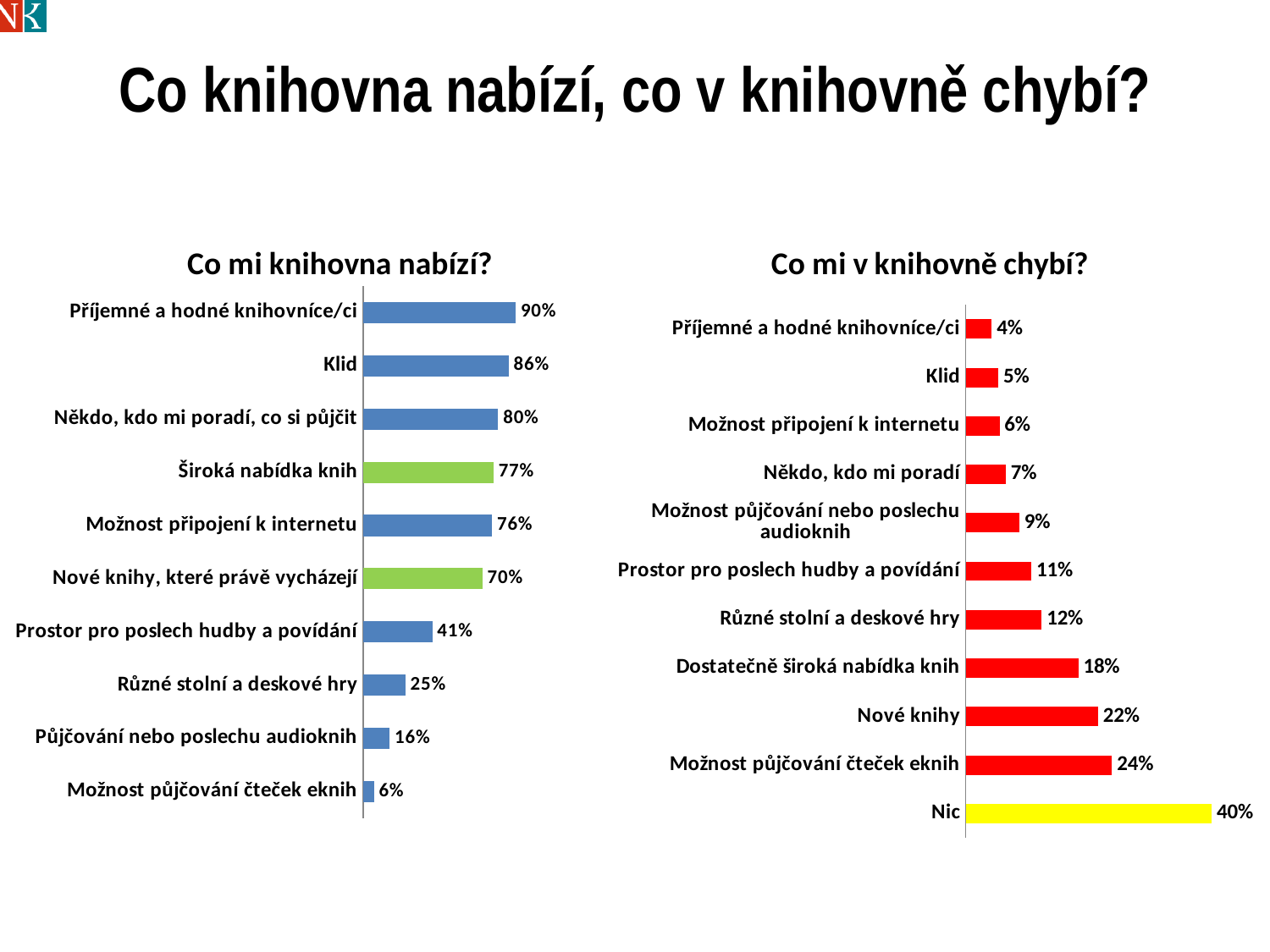
In the chart "Co mi v knihovně chybí?", what is the difference between "Možnost půjčování čteček eknih" and "Nic"? 16% How many categories are shown in the chart "Co mi v knihovně chybí?"? 11 In the chart "Co mi v knihovně chybí?", what is the value for "Nové knihy"? 22% In the chart "Co mi v knihovně chybí?", which category has the lowest value? Příjemné a hodné knihovníce/ci In the chart "Co mi knihovna nabízí?", what is the difference between "Široká nabídka knih" and "Nové knihy, které právě vycházejí"? 7% In the chart "Co mi knihovna nabízí?", what is the value for "Klid"? 86% In the chart "Co mi v knihovně chybí?", which category has the highest value? Nic In the chart "Co mi knihovna nabízí?", which category has the highest value? Příjemné a hodné knihovníce/ci In the chart "Co mi v knihovně chybí?", which is larger: "Různé stolní a deskové hry" or "Dostatečně široká nabídka knih"? Dostatečně široká nabídka knih What type of chart is "Co mi v knihovně chybí?"? Bar chart How many categories are shown in the chart "Co mi knihovna nabízí?"? 10 In the chart "Co mi v knihovně chybí?", what colour is the bar for "Nic"? Yellow